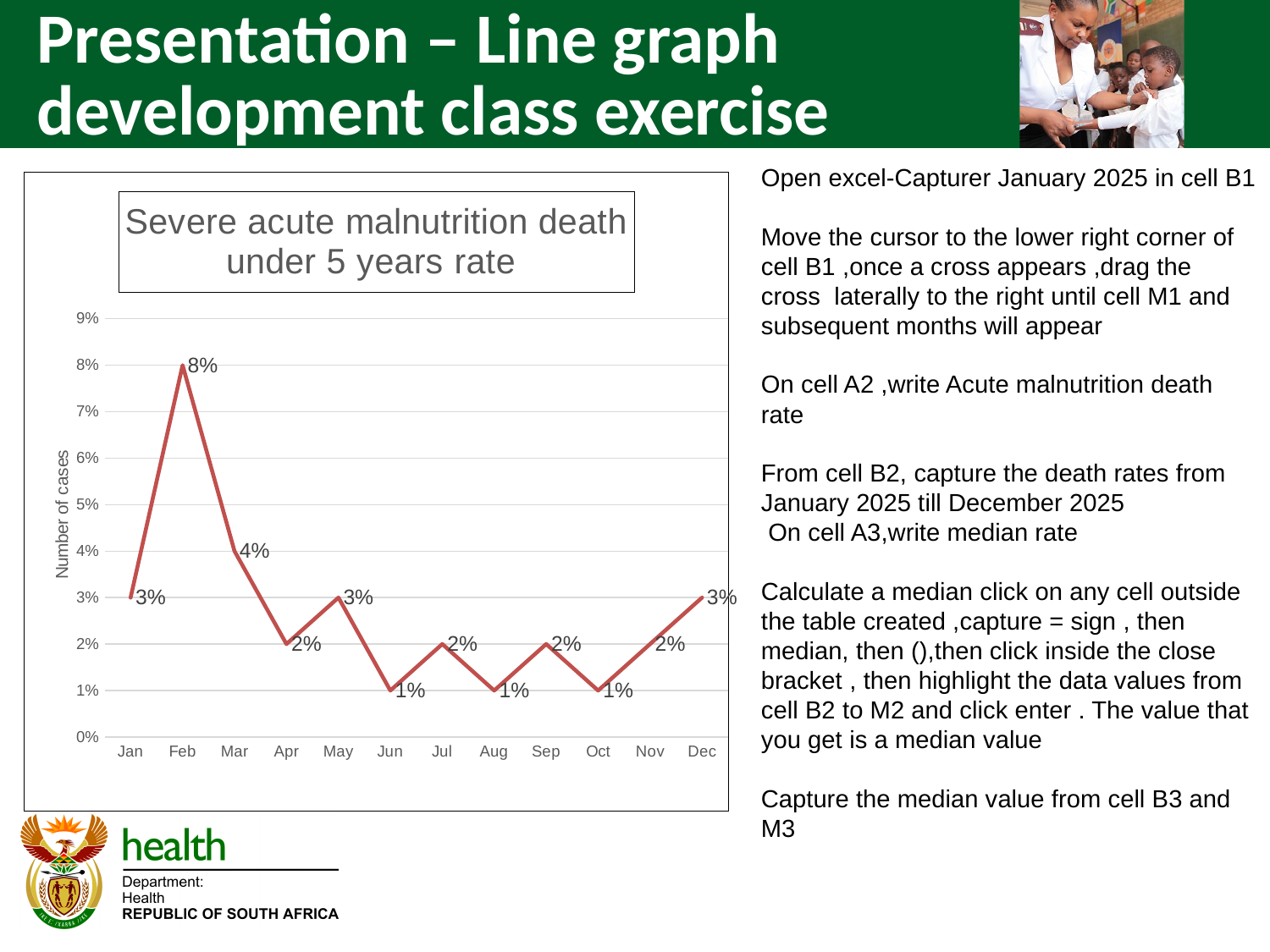
What is the value for Mar? 4% What is the value for Feb? 8% What is the value for Oct? 1% What is the lowest value plotted on the chart? 1% How many months are plotted on the x axis? 12 What is the difference between the values for Feb and Mar? 4% What kind of chart is shown on the slide? line chart Which month has the highest value? Feb What is the title of the chart? Severe acute malnutrition death under 5 years rate Which is larger, the value for Jan or the value for Apr? Jan Is the value for Feb greater or less than 5%? greater What is the value for Dec? 3%